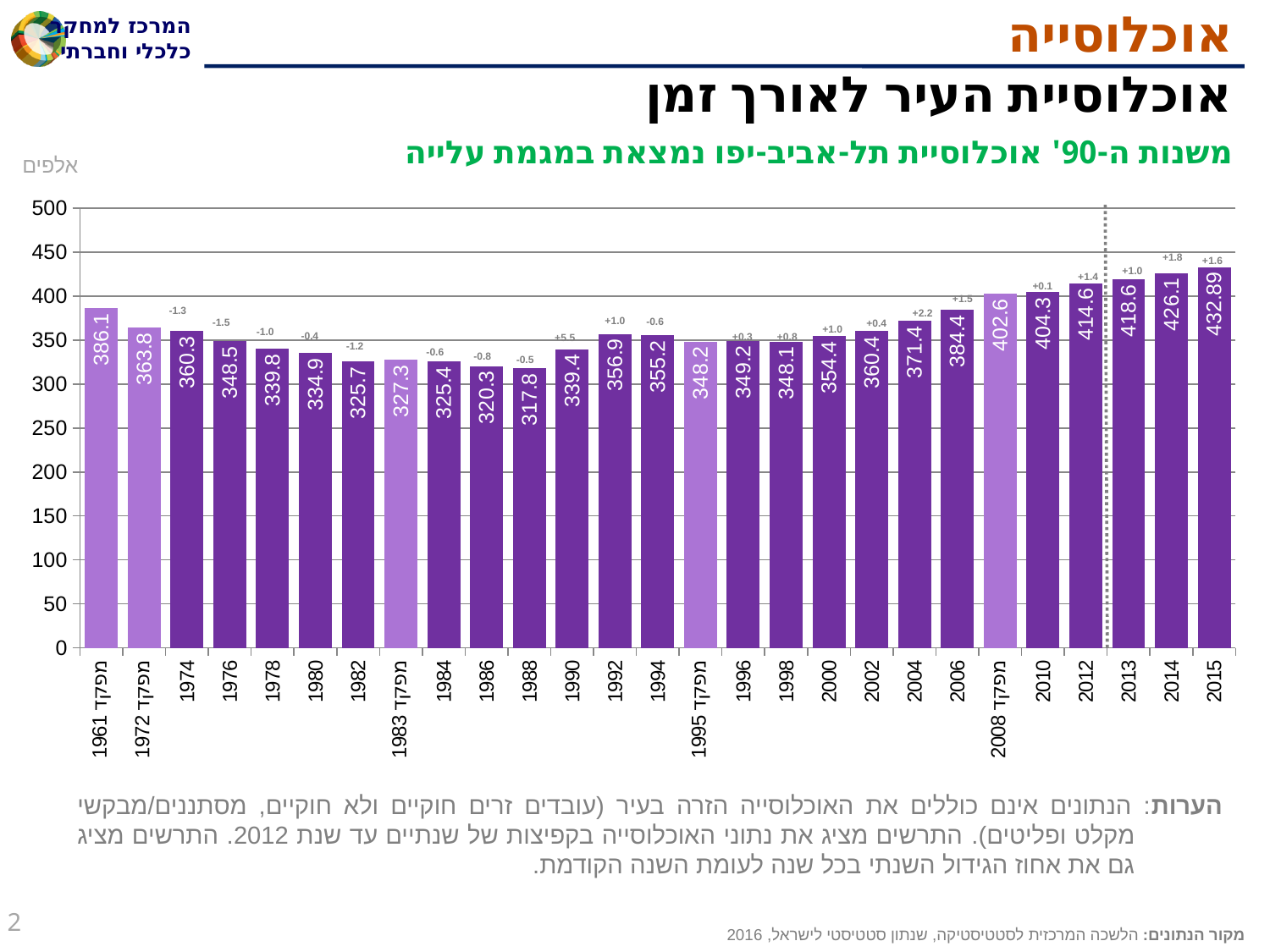
What is the population value shown for 2004? 371.4 Which is larger, the population value for 1992 or for 1994? 1992 What is the population value shown for מפקד 1961? 386.1 What is the difference between the population values for 2015 and 2014? 6.79 How many bars are plotted in the chart? 27 What is the population value shown for 1988? 317.8 Which year has the highest population value in the chart? 2015 What type of chart is shown on the slide? bar chart What is the population value shown for 2015? 432.89 Do the population values rise or fall from 1996 to 2015? rise Which year has the lowest population value in the chart? 1988 What is the difference between the population values for מפקד 1961 and 1988? 68.3